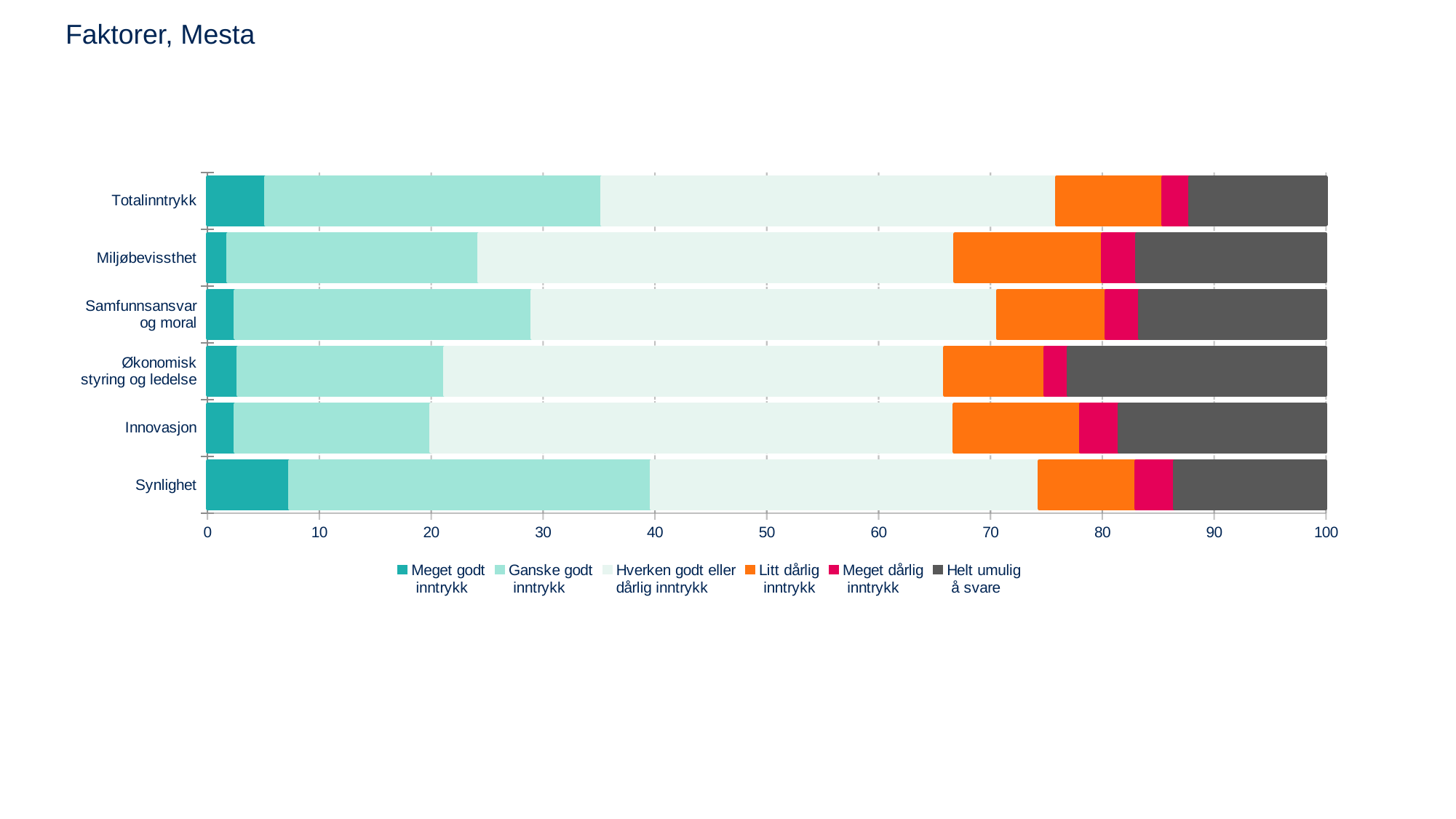
Which has the larger 'Hverken godt eller dårlig inntrykk' segment, Totalinntrykk or Synlighet? Totalinntrykk Which category has the largest 'Litt dårlig inntrykk' segment? Miljøbevissthet How many categories (bars) are shown on the chart? 6 Which category has the largest 'Helt umulig å svare' segment? Økonomisk styring og ledelse What kind of chart is shown on the slide? Stacked bar chart How many series does the legend list? 6 Is the 'Helt umulig å svare' value for Økonomisk styring og ledelse greater or less than 20? greater Is the 'Meget godt inntrykk' value for Synlighet greater or less than 10? less What is the title of the chart? Faktorer, Mesta Which category has the largest 'Meget godt inntrykk' segment? Synlighet What is the total of the stacked bar for Totalinntrykk? 100